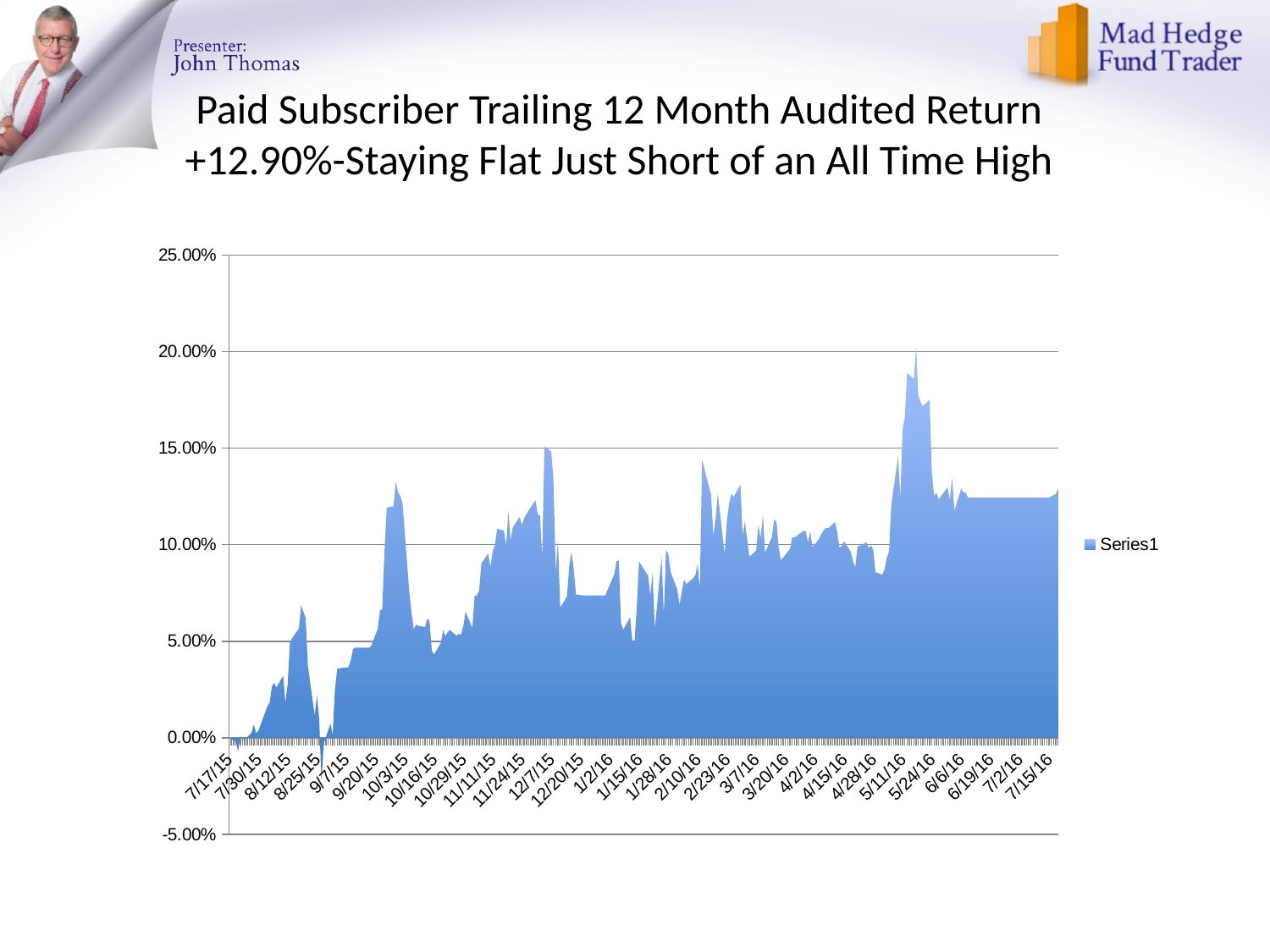
Is the value at 7/15/16 greater or less than 10.00%? greater Is the value at 12/20/15 greater or less than 10.00%? less How many series does the legend list? 1 What is the title of the slide above the chart? Paid Subscriber Trailing 12 Month Audited Return +12.90%-Staying Flat Just Short of an All Time High What is the name of the series shown in the legend? Series1 Is the value at 1/2/16 greater or less than 10.00%? less What kind of chart is shown on the slide? area chart Which is larger, the value at 7/15/16 or the value at 7/17/15? 7/15/16 Overall, do the values rise or fall from 7/17/15 to 7/15/16? rise